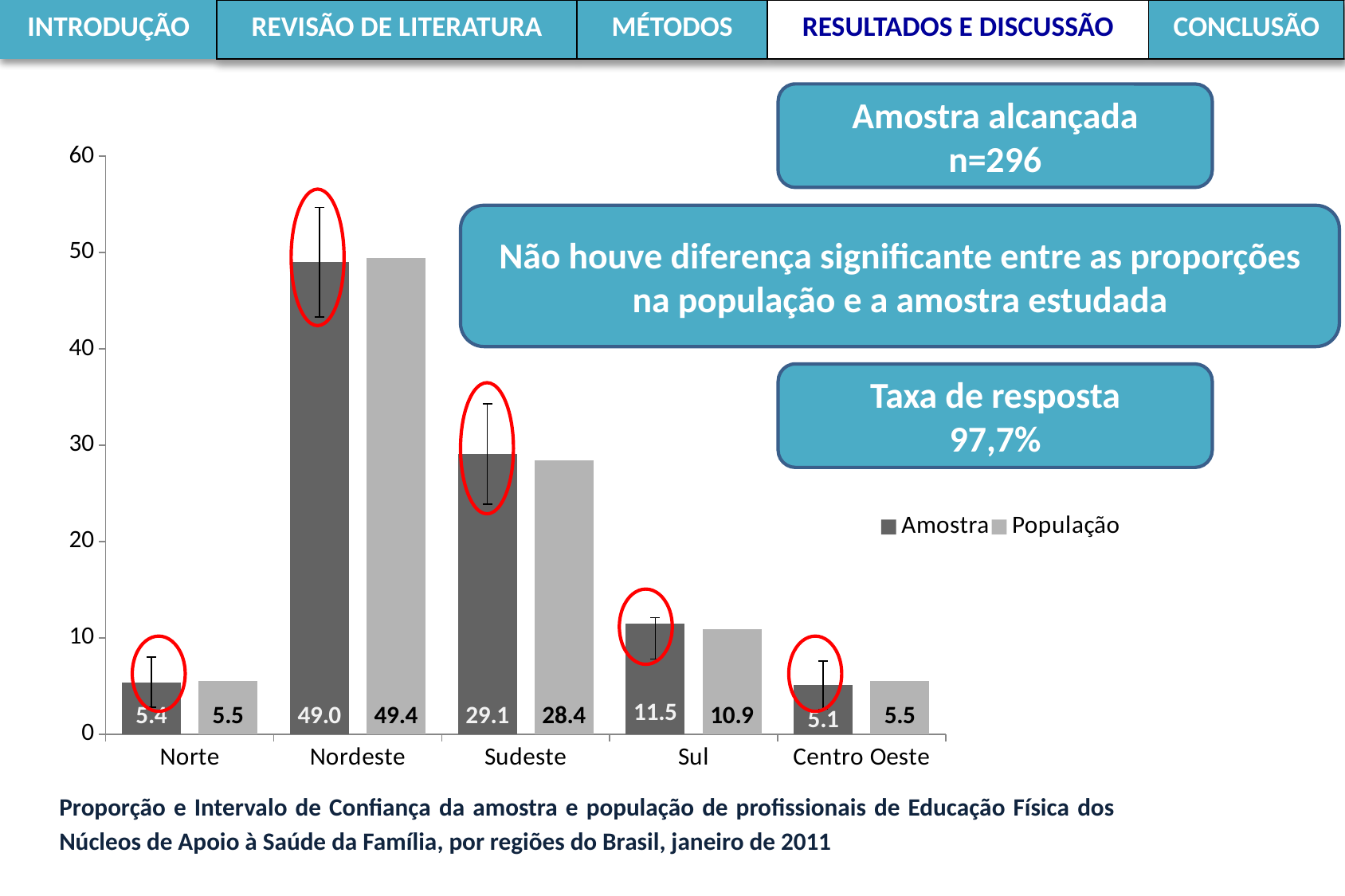
What is the difference between the Amostra values for Nordeste and Sudeste? 19.9 Which region has the lowest Amostra value? Centro Oeste What kind of chart is shown on the slide? bar chart Which is larger for Sudeste, the Amostra value or the População value? Amostra What is the Amostra value for Centro Oeste? 5.1 Is the Amostra value for Nordeste greater or less than 40? greater What is the Amostra value for Nordeste? 49.0 Which region has the highest Amostra value? Nordeste How many regions are shown on the x axis? 5 What is the População value for Sudeste? 28.4 How many series does the legend list? 2 What is the difference between the Amostra and População values for Sul? 0.6